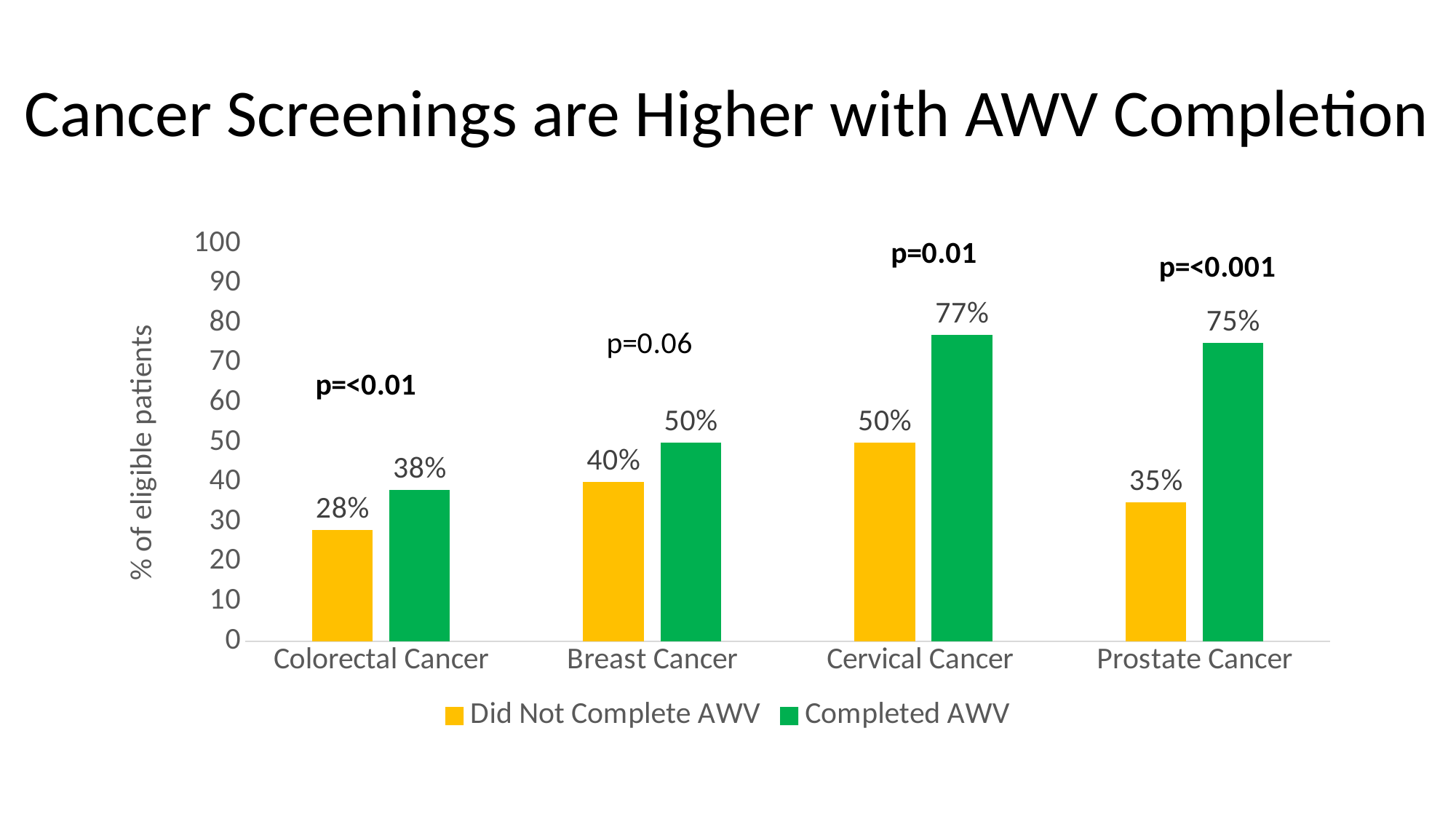
How many series does the legend list? 2 Which cancer type has the highest screening rate among patients who completed an AWV? Cervical Cancer What is the value for Did Not Complete AWV for Prostate Cancer? 35% What percentage of eligible patients who completed an AWV received colorectal cancer screening? 38% What is the value for Completed AWV for Cervical Cancer? 77% What p-value is shown above the Breast Cancer bars? p=0.06 What is the difference between the Completed AWV and Did Not Complete AWV values for Prostate Cancer? 40% Which is larger: the Did Not Complete AWV value for Cervical Cancer or the Completed AWV value for Colorectal Cancer? Did Not Complete AWV for Cervical Cancer What kind of chart is shown on the slide? Bar chart Which cancer type has the lowest screening rate among patients who did not complete an AWV? Colorectal Cancer What is the difference between the Completed AWV and Did Not Complete AWV values for Breast Cancer? 10% How many cancer types are shown on the x axis? 4